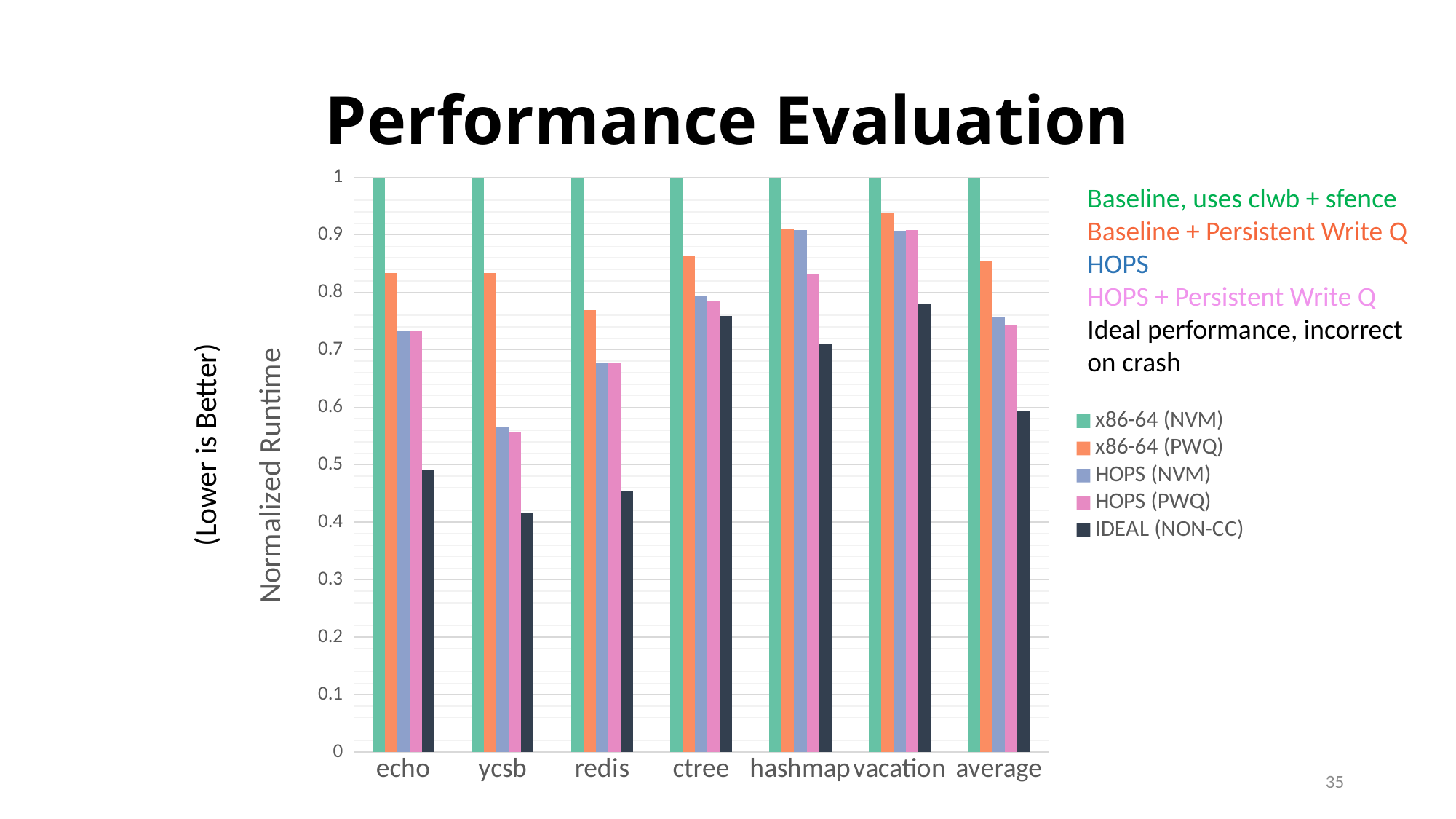
What is the value of x86-64 (NVM) for redis? 1 Which is larger, the x86-64 (PWQ) value for echo or for ctree? ctree Is the value of HOPS (NVM) for redis greater or less than 0.7? less How many categories are shown on the x axis of the chart? 7 What is the title of the vertical axis of the chart? Normalized Runtime How many series does the chart legend list? 5 Which category has the highest x86-64 (PWQ) value? vacation Is the value of IDEAL (NON-CC) for ycsb greater or less than 0.5? less What kind of chart is shown on the slide? bar chart Is the value of x86-64 (PWQ) for echo greater or less than 0.8? greater Which category has the lowest IDEAL (NON-CC) value? ycsb